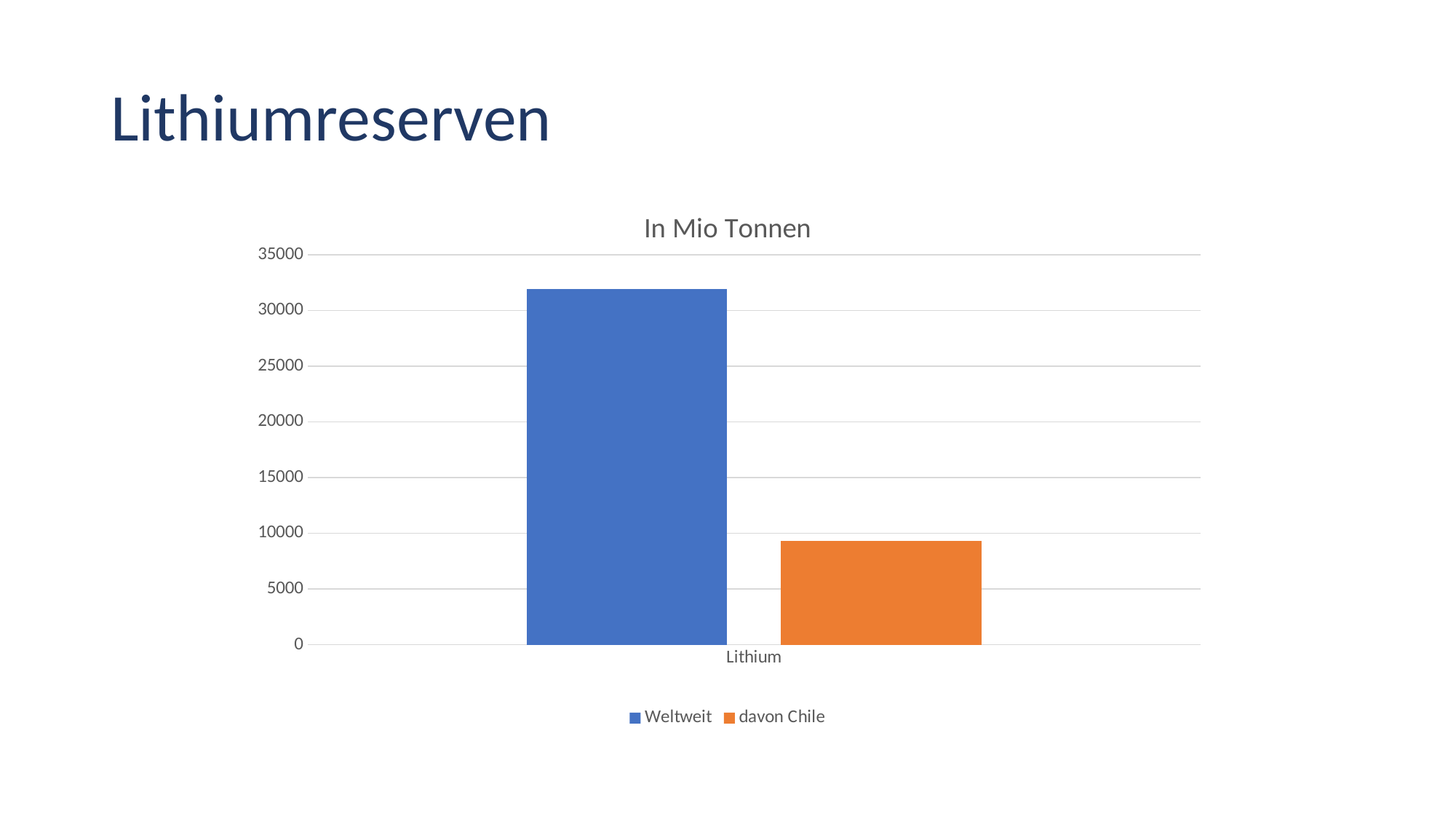
What kind of chart is shown on the slide? bar chart What is the title of the chart? In Mio Tonnen Which series is shown in orange? davon Chile How many categories are shown on the x axis? 1 How many series does the legend list? 2 Is the value for Weltweit greater or less than 35000? less Which series has the lowest value in the chart? davon Chile Which series has the higher value for Lithium, Weltweit or davon Chile? Weltweit Is the value for davon Chile greater or less than 5000? greater What is the label of the category on the x axis? Lithium Is the value for Weltweit greater or less than 30000? greater